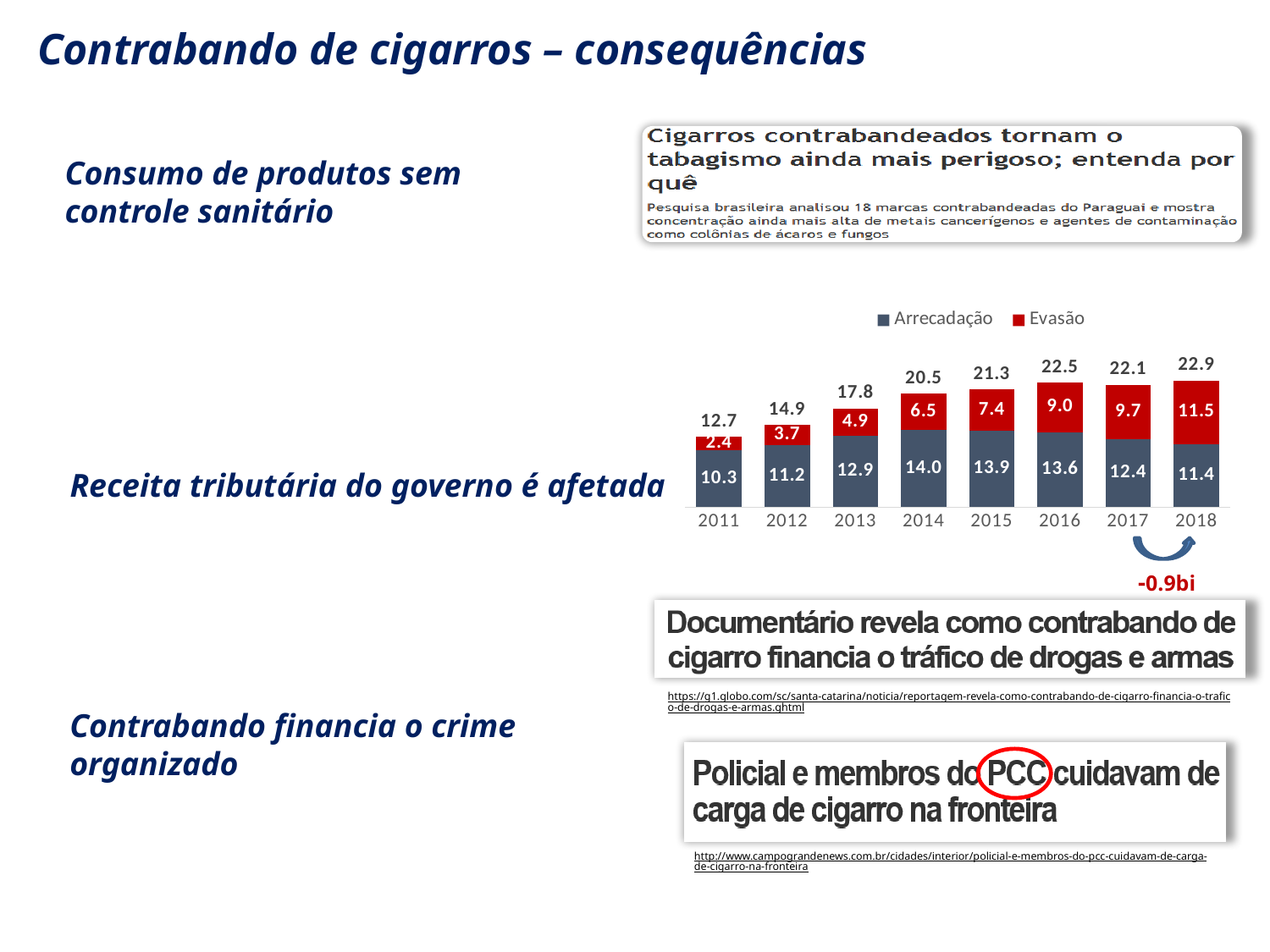
Which is larger, the Arrecadação value for 2014 or for 2018? 2014 What is the Evasão value for 2018? 11.5 What colour represents the Evasão series in the chart? red Does the Evasão value rise or fall from 2011 to 2018? rise What type of chart is shown on the slide? stacked bar chart Which year has the highest Evasão value? 2018 Which year has the lowest Arrecadação value? 2011 How many years are shown on the x axis of the chart? 8 What is the total value printed above the 2016 bar? 22.5 How many series does the chart legend list? 2 What is the Arrecadação value for 2014? 14.0 What is the difference between the Evasão values for 2018 and 2011? 9.1